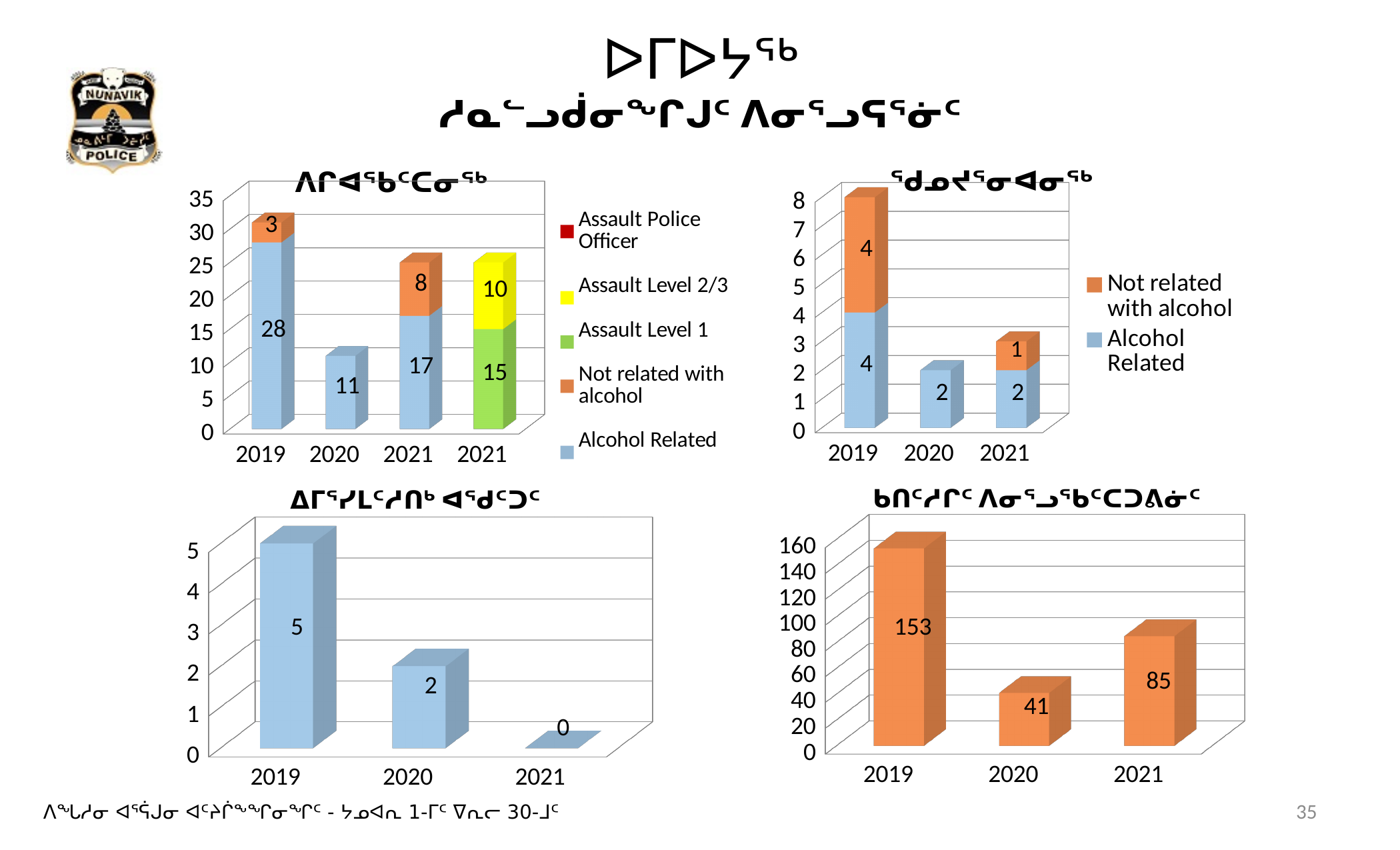
How many series does the legend of the top-right chart list? 2 In the top-left chart, what is the total of the stacked bar made up of Assault Level 1 and Assault Level 2/3? 25 In the bottom-left chart, do the values rise or fall from 2019 to 2021? fall In the bottom-right chart, what is the value for 2019? 153 In the bottom-left chart, which year has the highest value? 2019 In the top-left chart, what is the Alcohol Related value for 2019? 28 In the bottom-right chart, which year has the lowest value? 2020 How many series does the legend of the top-left chart list? 5 In the top-right chart, what is the total of the stacked bar for 2019? 8 In the top-right chart, what is the Not related with alcohol value for 2021? 1 In the bottom-right chart, what is the difference between the values for 2019 and 2021? 68 In the bottom-left chart, what is the value for 2021? 0